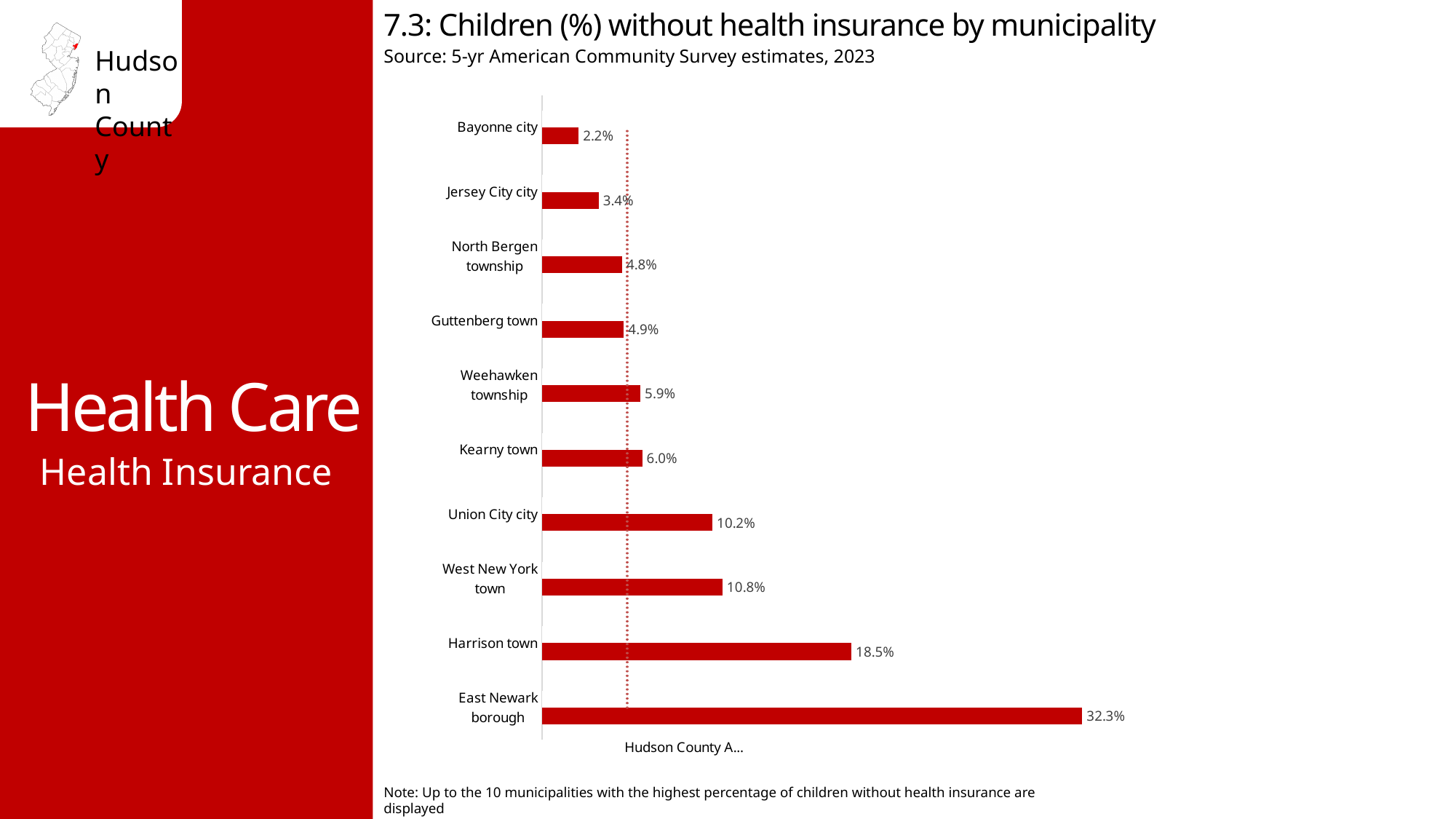
Which municipality has the lowest percentage of children without health insurance? Bayonne city What is the value shown for Harrison town? 18.5% What percentage is shown for West New York town? 10.8% Which has a higher value, Kearny town or Guttenberg town? Kearny town What kind of chart is shown on the slide? Bar chart What is the difference between the values for East Newark borough and Harrison town? 13.8% How many municipalities are shown in the chart? 10 What percentage of children are without health insurance in Bayonne city? 2.2% What is the difference between the values for Union City city and Jersey City city? 6.8% What does the dotted vertical line on the chart represent, according to its label? Hudson County A... Which municipality has the highest percentage of children without health insurance? East Newark borough What is the source cited for the chart? 5-yr American Community Survey estimates, 2023